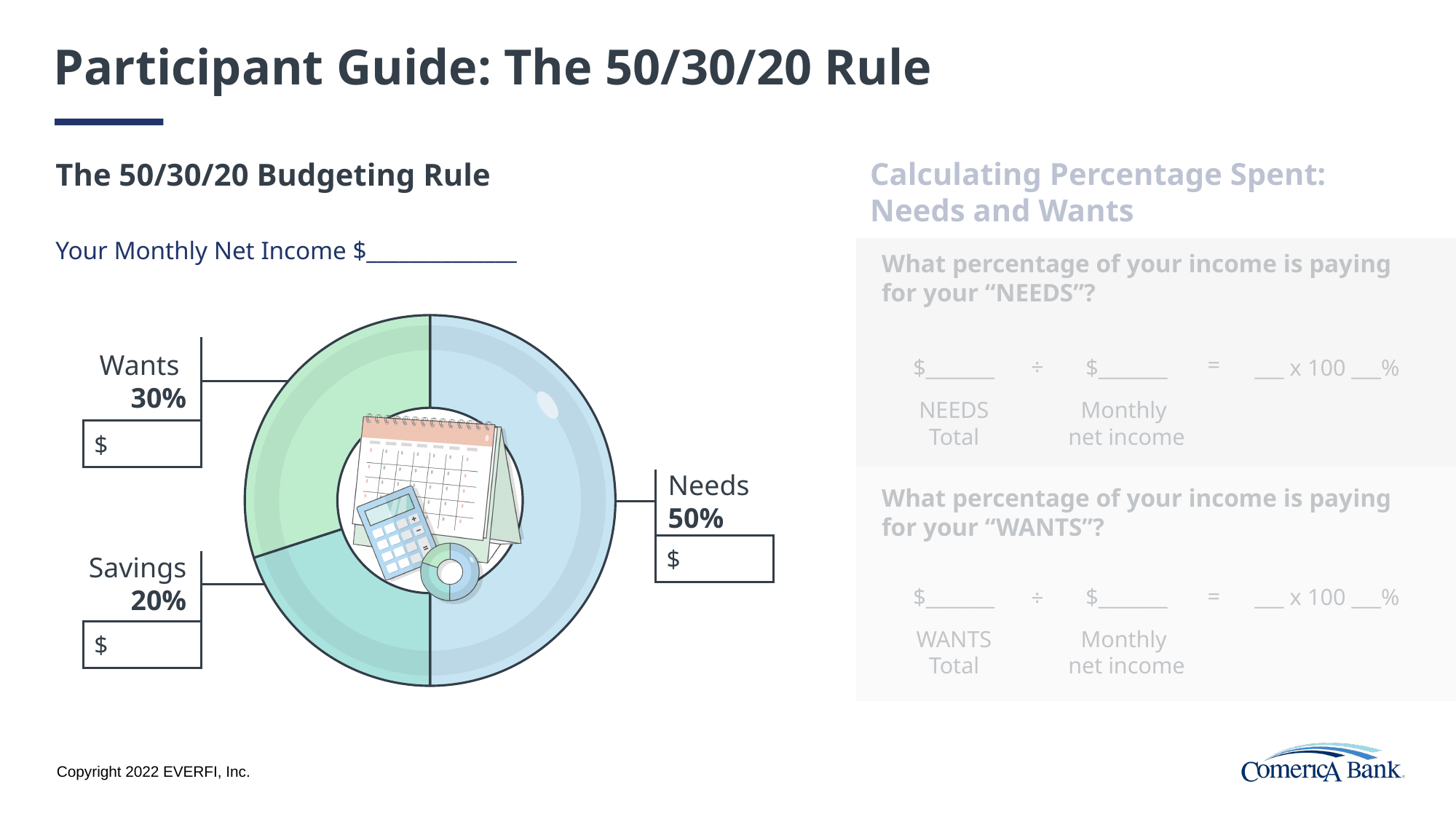
What is the difference in percentage points between Needs and Wants? 20% What is the heading above the chart? The 50/30/20 Budgeting Rule What colour is the Needs slice of the chart? Light blue Which category has the largest share of the chart? Needs What percentage is shown for Wants? 30% What percentage is shown for Savings? 20% What percentage is shown for Needs? 50% How many categories does the chart show? 3 What kind of chart is shown on the slide? Pie chart (donut) Which is larger, the share for Wants or the share for Savings? Wants Which category has the smallest share of the chart? Savings What is the difference in percentage points between Wants and Savings? 10%